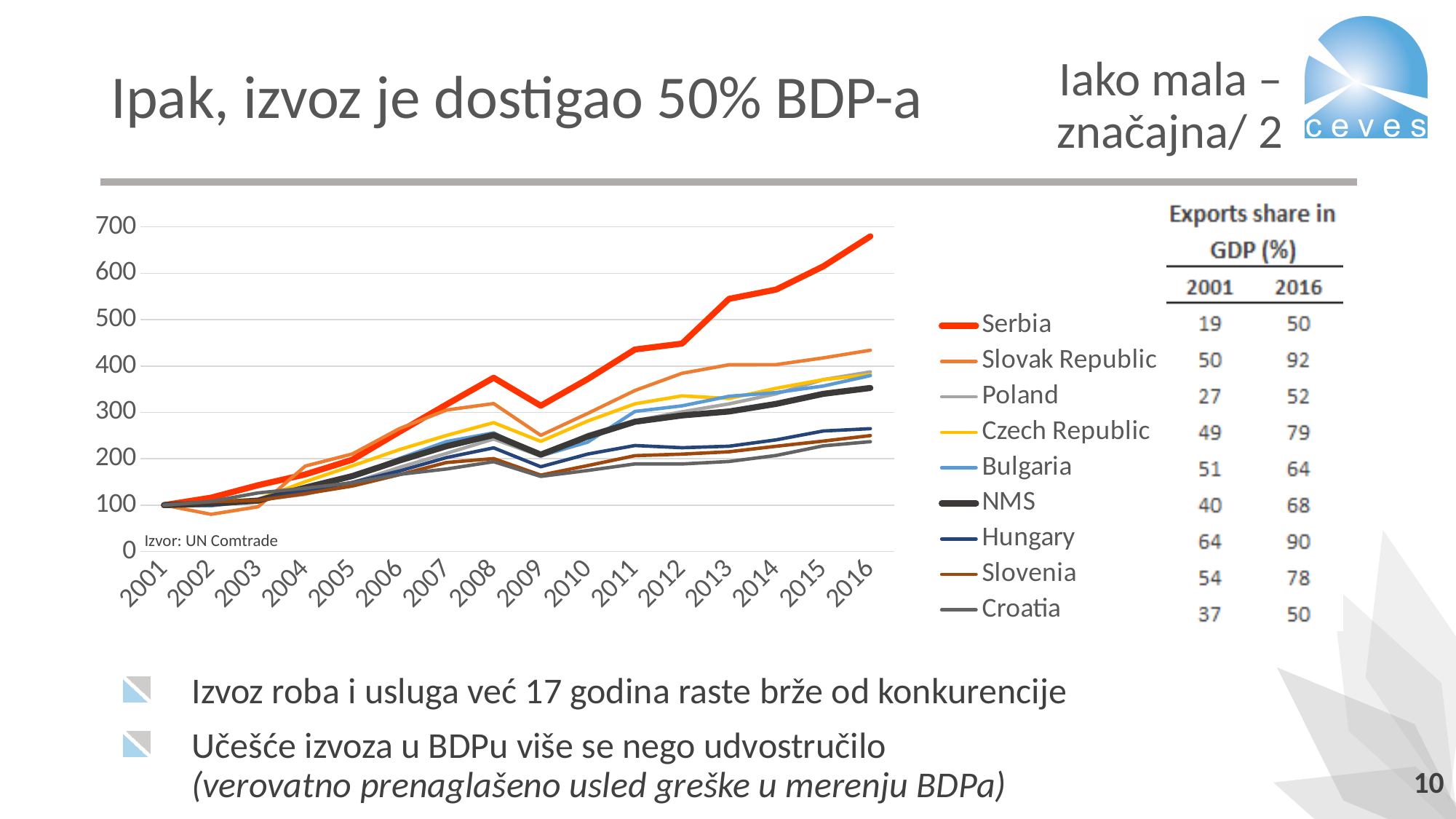
How many years are shown along the x axis of the chart? 16 In 2016, which is larger: the value for Serbia or the value for Slovak Republic? Serbia What kind of chart is shown on the slide? Line chart How many series does the chart's legend list? 9 Is the value for Slovak Republic in 2016 greater or less than 400? greater What source is cited below the chart? UN Comtrade Is the value for Serbia in 2016 greater or less than 600? greater Is the value for Hungary in 2016 greater or less than 300? less Does the Serbia line generally rise or fall from 2001 to 2016? Rise In 2016, which is larger: the value for Poland or the value for Hungary? Poland Which series has the highest value in 2016? Serbia